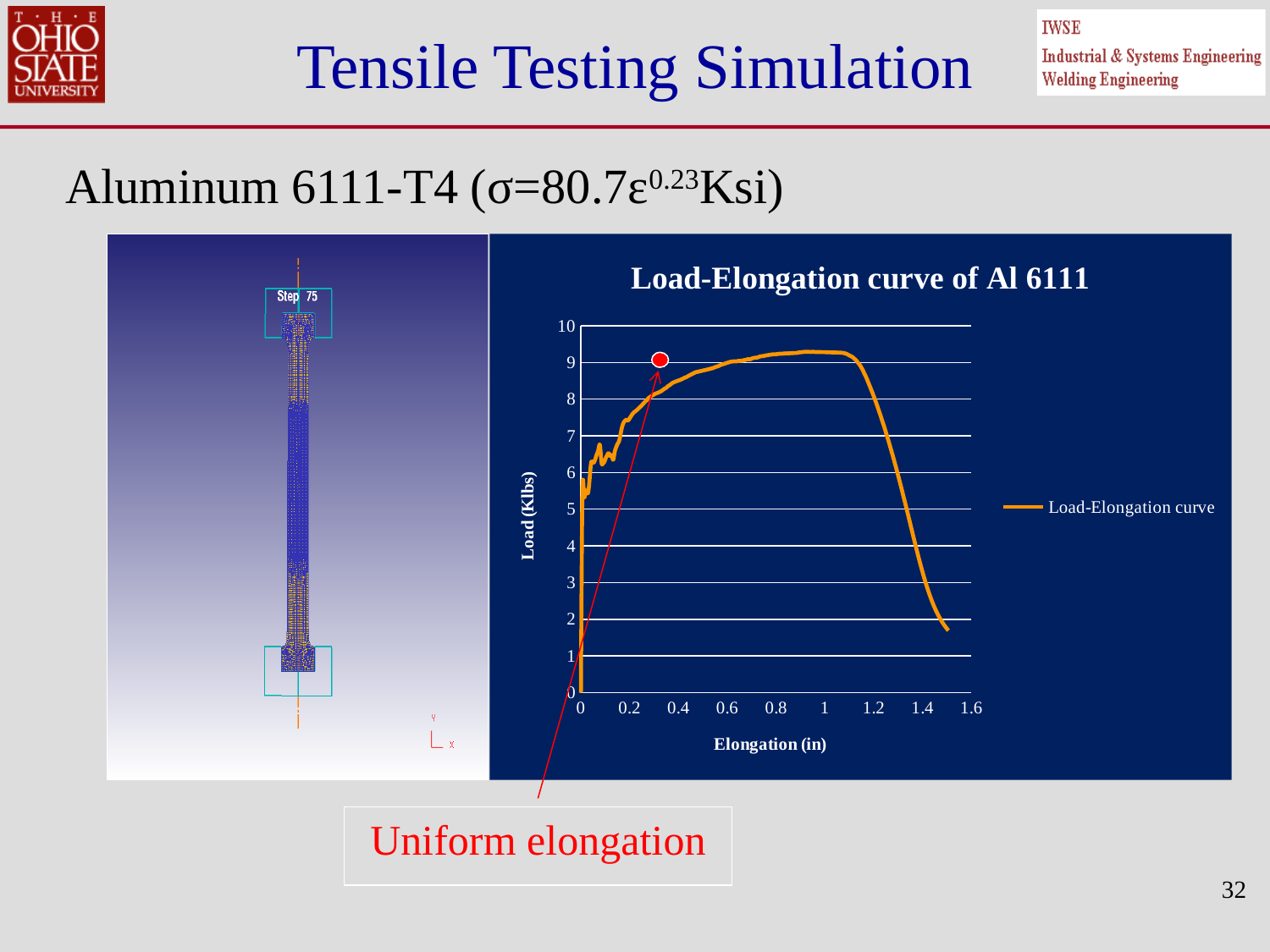
Is the load at an elongation of 1.4 in greater or less than 4 Klbs? less What kind of chart is shown on the slide? line chart Is the load at an elongation of 1.0 in larger or smaller than the load at an elongation of 1.4 in? larger Is the load at an elongation of 0.6 in greater or less than 8 Klbs? greater Does the load rise or fall as elongation increases from 1.2 to 1.5 in? fall Is the load at an elongation of 0.2 in greater or less than 7 Klbs? greater What is the maximum value shown on the y axis of the chart? 10 What is the label of the x axis of the chart? Elongation (in) How many series does the chart legend list? 1 What is the title of the chart? Load-Elongation curve of Al 6111 Does the load rise or fall as elongation increases from 0 to 0.8 in? rise